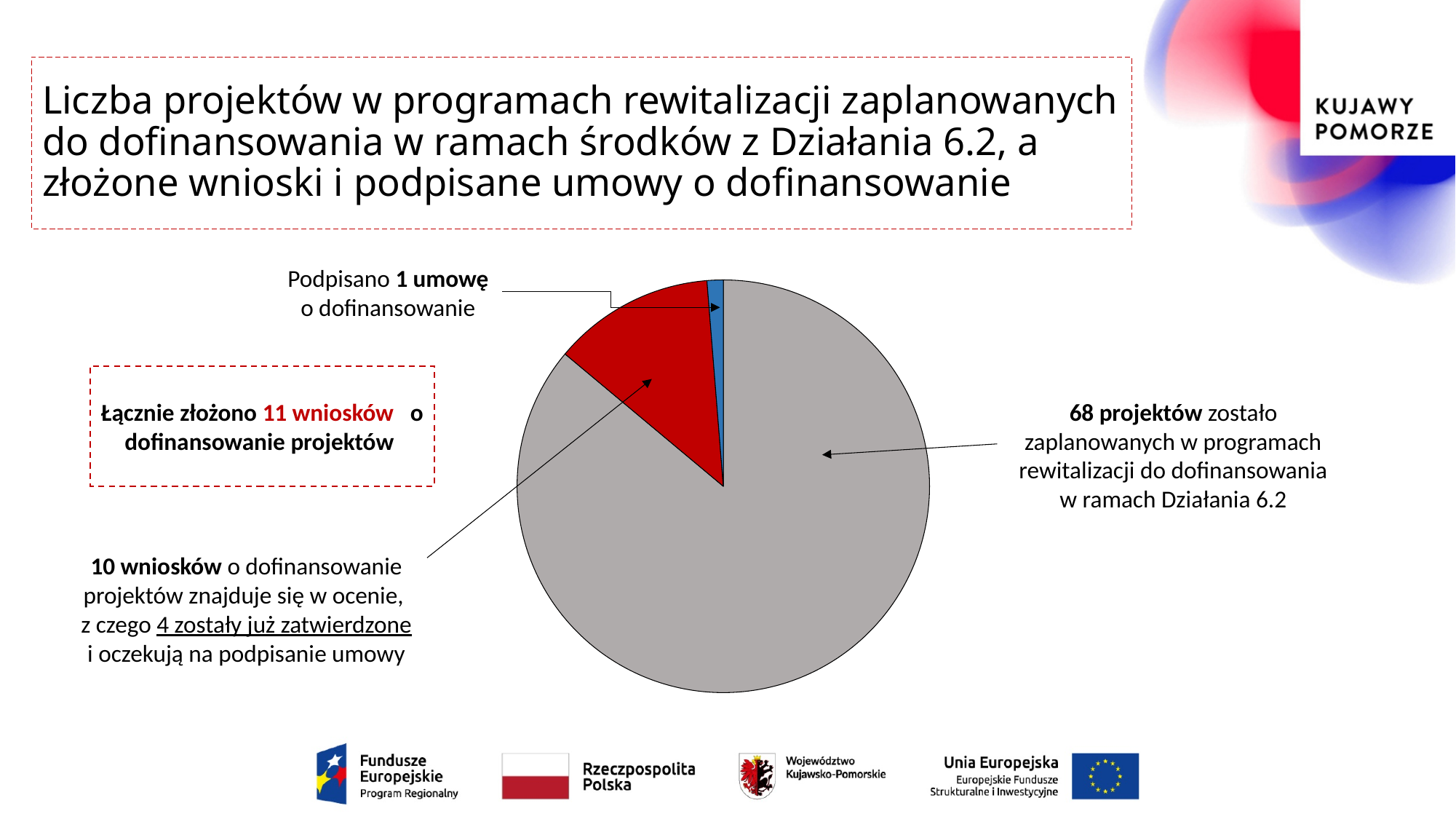
How many projects were planned in the revitalisation programmes for funding under Działanie 6.2, according to the label on the largest slice? 68 projektów How many funding applications were submitted in total, according to the boxed text on the left? 11 wniosków How many funding applications are currently under evaluation, according to the label pointing to the red slice? 10 wniosków What is the difference between the number of applications under evaluation and the number of signed contracts? 9 Which slice of the pie chart is the smallest? Podpisano 1 umowę (signed contract) What kind of chart is shown on the slide? pie chart Which slice of the pie chart is the largest? 68 projektów (planned projects) Which is larger: the number of applications under evaluation or the number of signed contracts? applications under evaluation (10) How many slices does the pie chart have? 3 How many funding contracts have been signed, according to the label pointing to the blue slice? 1 umowę Of the applications under evaluation, how many have already been approved and await contract signing? 4 What colour is the slice representing the 10 applications under evaluation? red